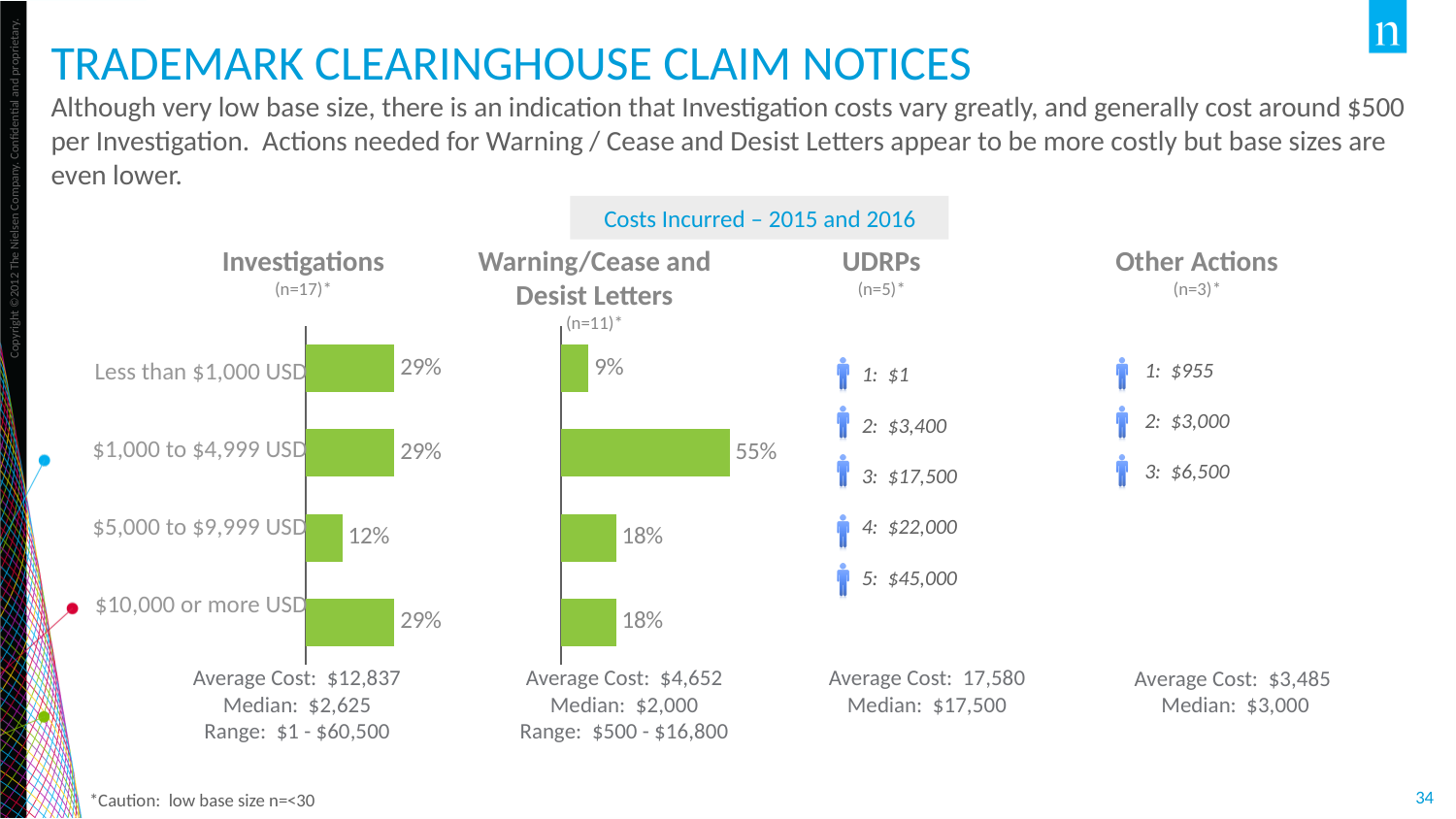
How many cost categories are shown in the Investigations chart? 4 In the Investigations chart, which cost category has the lowest percentage? $5,000 to $9,999 USD In the Warning/Cease and Desist Letters chart, which cost category has the lowest percentage? Less than $1,000 USD What type of chart is the Investigations chart? Bar chart In the Warning/Cease and Desist Letters chart, what is the difference between the percentages for $1,000 to $4,999 USD and $5,000 to $9,999 USD? 37% In the Warning/Cease and Desist Letters chart, what percentage is shown for $1,000 to $4,999 USD? 55% In the Warning/Cease and Desist Letters chart, what percentage is shown for Less than $1,000 USD? 9% In the Warning/Cease and Desist Letters chart, which cost category has the highest percentage? $1,000 to $4,999 USD In the Investigations chart, what percentage is shown for $10,000 or more USD? 29% In the Investigations chart, what percentage is shown for $5,000 to $9,999 USD? 12% Which is larger: the percentage for $1,000 to $4,999 USD in the Investigations chart or in the Warning/Cease and Desist Letters chart? Warning/Cease and Desist Letters In the Investigations chart, what is the difference between the percentages for Less than $1,000 USD and $5,000 to $9,999 USD? 17%